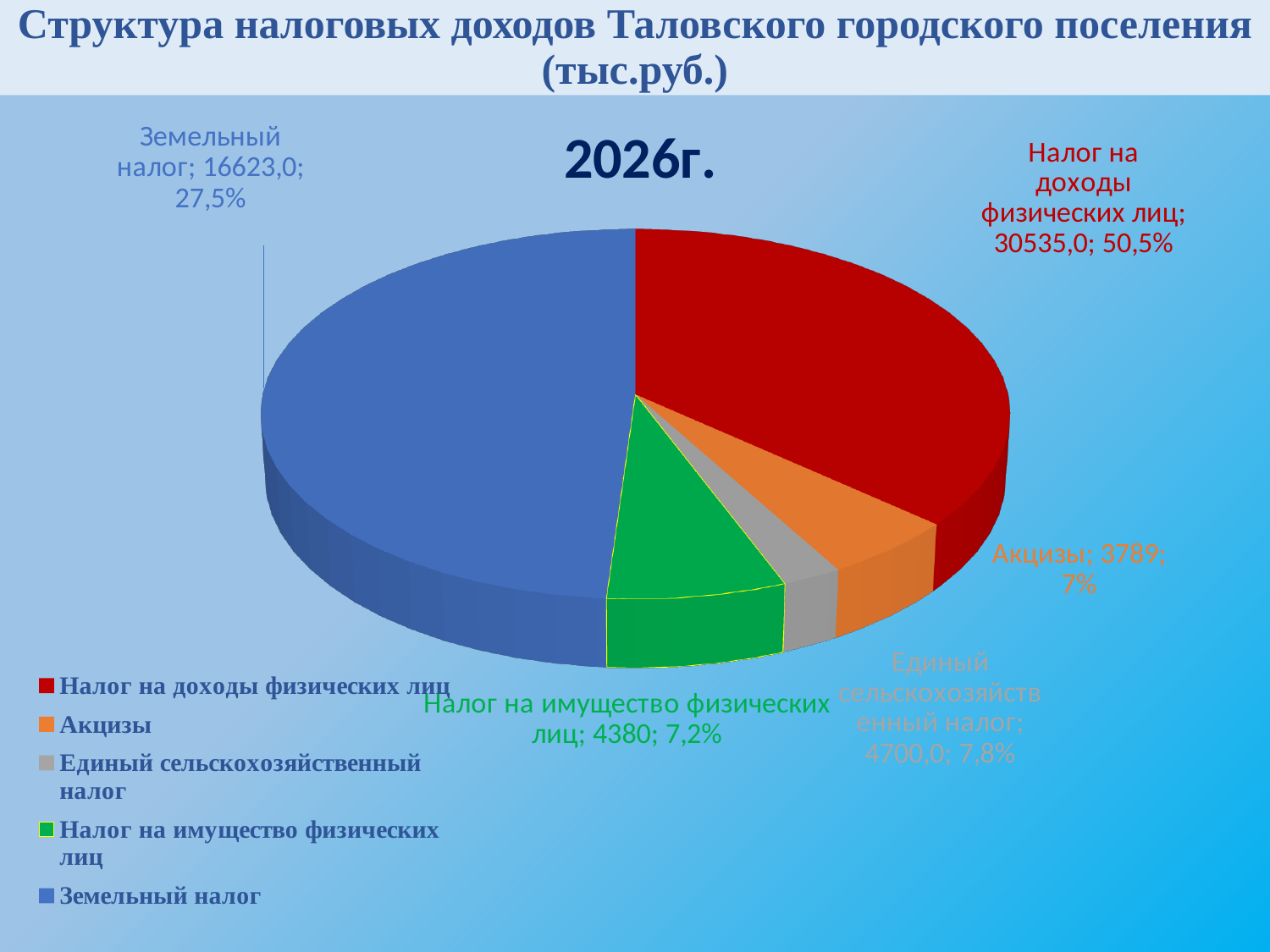
What share of the pie does Земельный налог represent? 27,5% What share of the pie does Налог на имущество физических лиц represent? 7,2% What is the value for Налог на доходы физических лиц? 30535,0 What is the value for Акцизы? 3789 What is the value for Земельный налог? 16623,0 How many categories does the pie chart have? 5 What kind of chart is shown on the slide? pie chart What year is shown as the chart title? 2026г. What is the value for Единый сельскохозяйственный налог? 4700,0